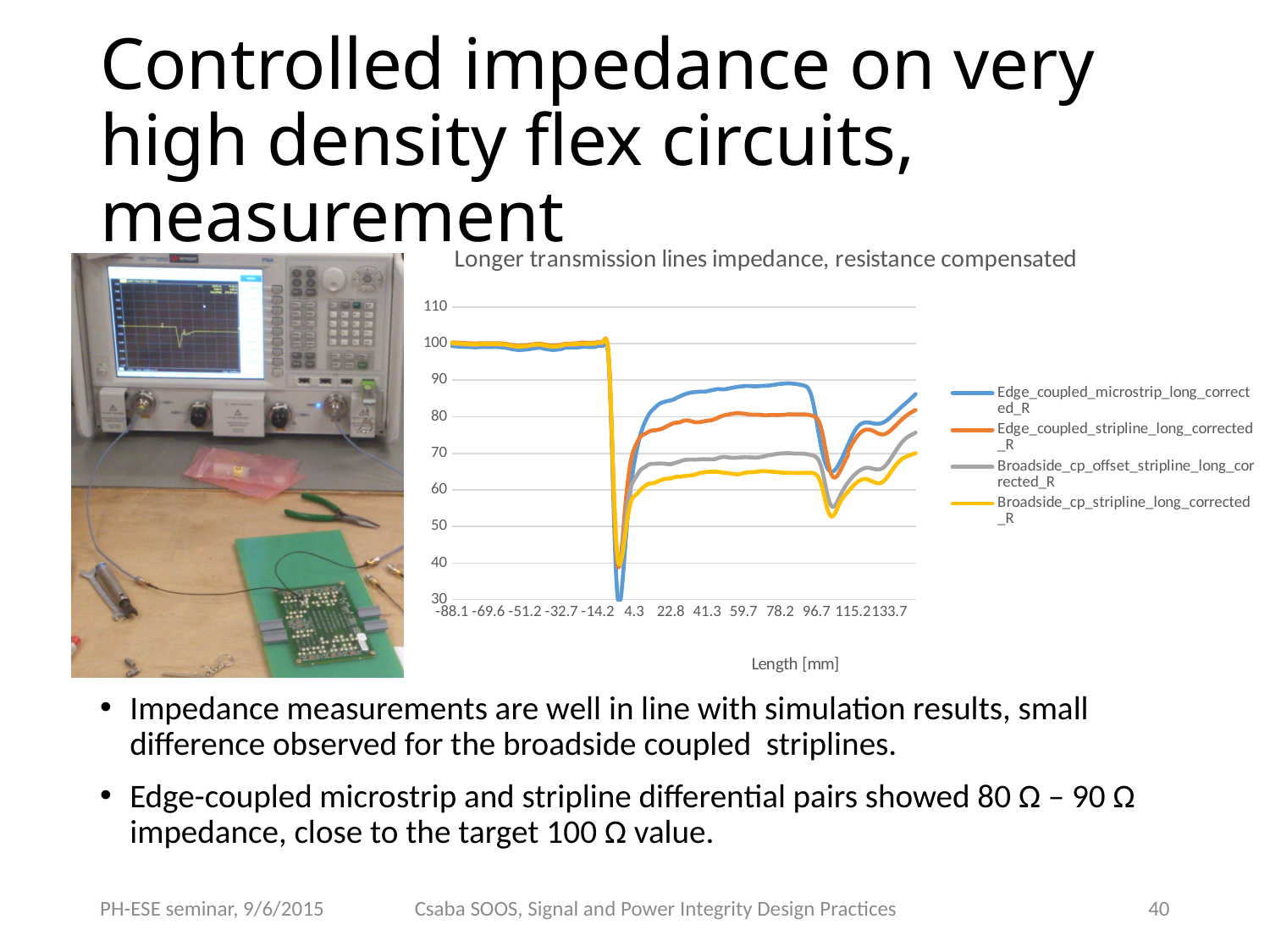
Is the value of Edge_coupled_microstrip_long_corrected_R at -88.1 mm greater or less than 90? greater What is the label of the x axis of the chart? Length [mm] What is the title of the chart? Longer transmission lines impedance, resistance compensated Which series has the lowest value at 78.2 mm? Broadside_cp_stripline_long_corrected_R Is the value of Broadside_cp_stripline_long_corrected_R at 78.2 mm greater or less than 70? less At 41.3 mm, which series has the higher value: Edge_coupled_microstrip_long_corrected_R or Broadside_cp_stripline_long_corrected_R? Edge_coupled_microstrip_long_corrected_R Is the value of Edge_coupled_microstrip_long_corrected_R at 78.2 mm greater or less than 80? greater How many series does the chart legend list? 4 How many tick labels are shown on the x axis of the chart? 13 What kind of chart is shown on the slide? line chart Which series has the highest value at 59.7 mm? Edge_coupled_microstrip_long_corrected_R